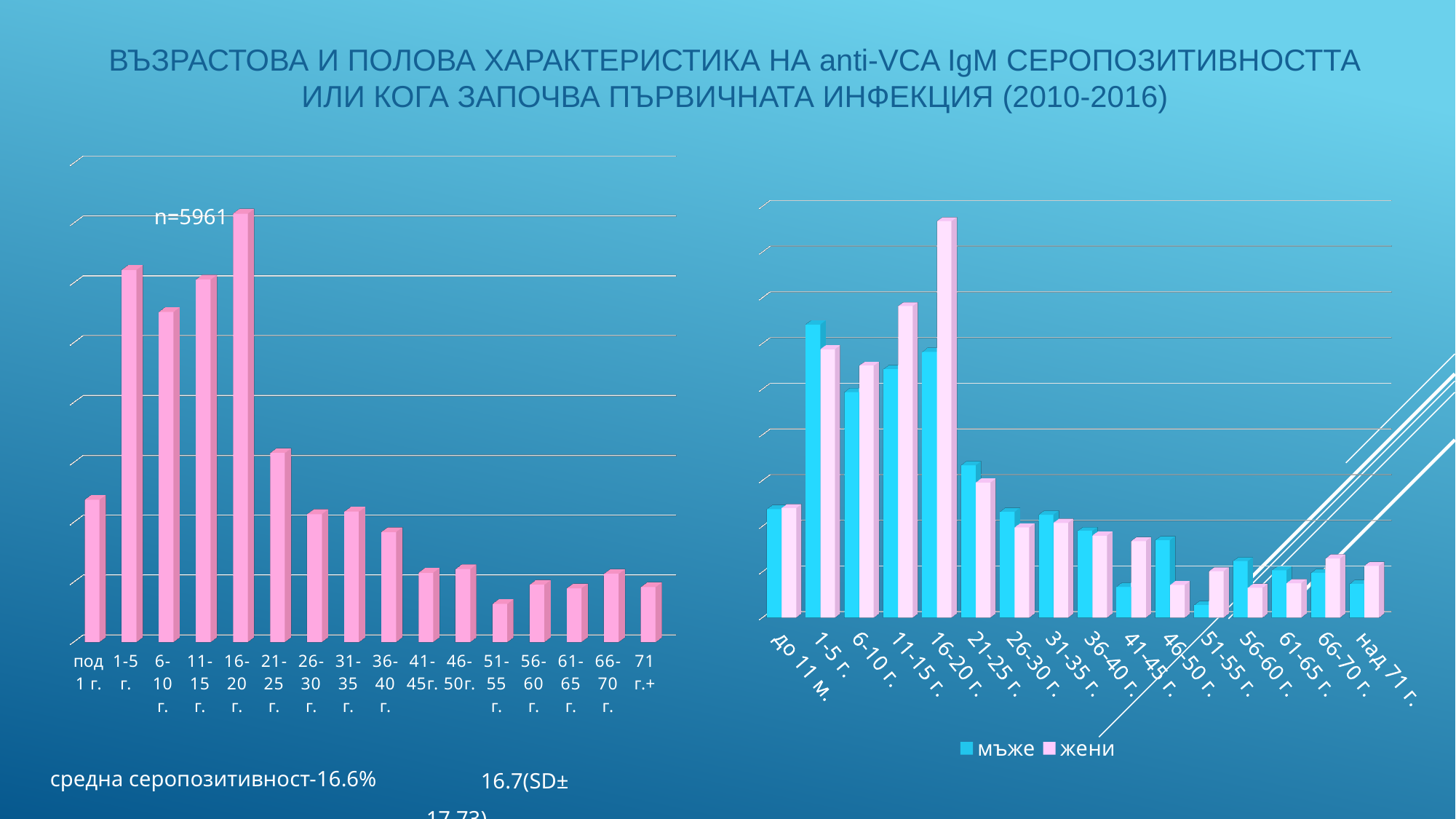
How many series does the legend of the right chart list? 2 In the right chart, for the 16-20 г. group, which series has the larger bar, мъже or жени? жени What kind of chart is the left chart on the slide? bar chart In the right chart, which age group has the highest bar for мъже? 1-5 г. In the left chart, is the bar for 1-5 г. larger or smaller than the bar for 6-10 г.? larger In the right chart, which age group has the highest bar for жени? 16-20 г. In the left chart, which age group has the lowest bar? 51-55 г. How many age-group categories are shown in the left chart? 16 In the left chart, which age group has the highest bar? 16-20 г. In the left chart, do the bars generally rise or fall from 16-20 г. to 51-55 г.? fall What sample size (n) is printed on the left chart? n=5961 What kind of chart is the right chart on the slide? bar chart